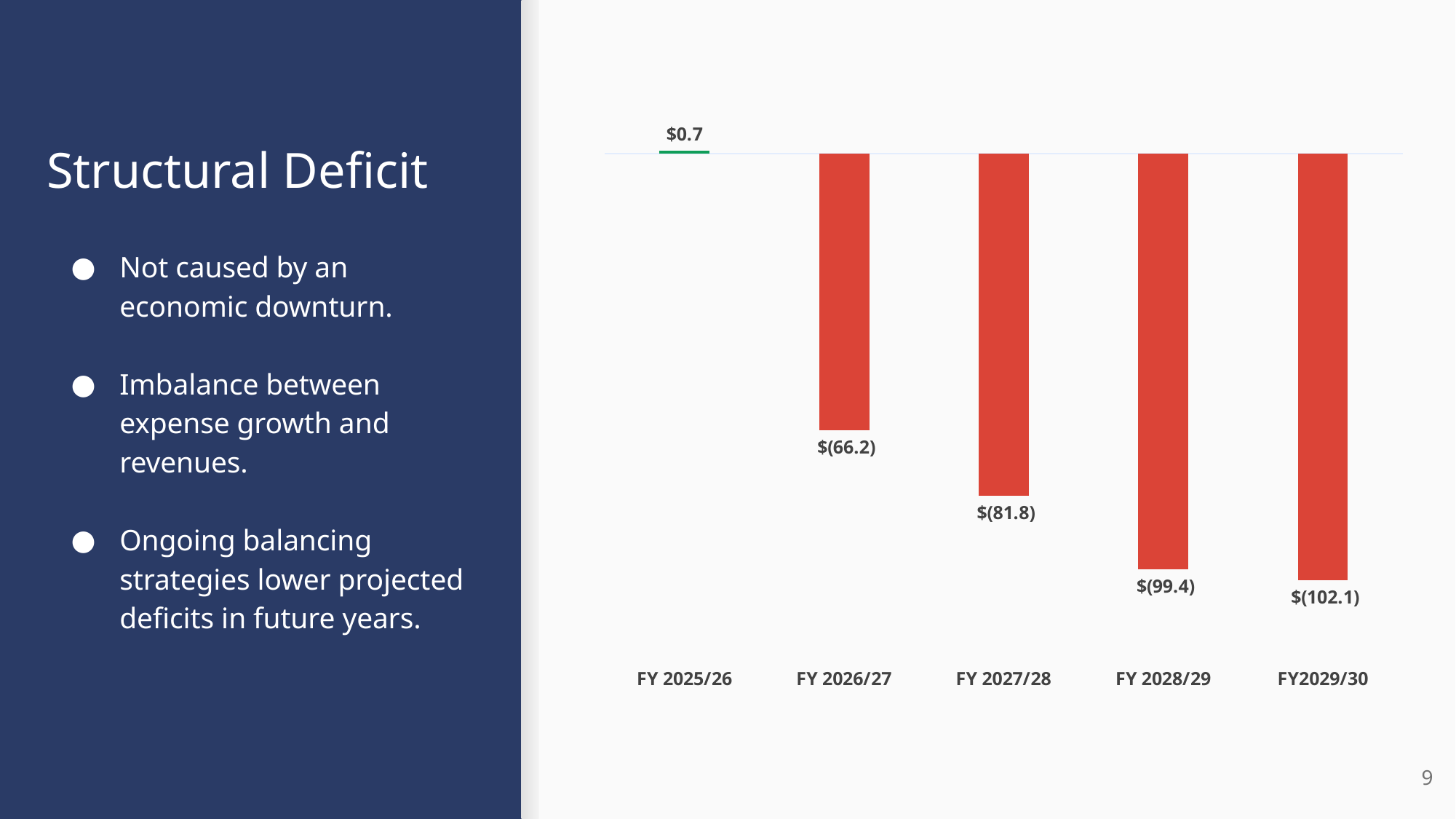
Which fiscal year has the lowest value (largest deficit)? FY2029/30 What kind of chart is shown on the slide? Bar chart What is the value for FY 2025/26? $0.7 By how much does the deficit for FY 2027/28 exceed the deficit for FY 2026/27? $15.6 Which fiscal year has the larger deficit, FY 2028/29 or FY2029/30? FY2029/30 What is the value for FY2029/30? $(102.1) What is the value for FY 2026/27? $(66.2) How many fiscal years are shown on the chart? 5 Do the values rise or fall from FY 2025/26 to FY2029/30? Fall Which fiscal year has the highest value? FY 2025/26 What is the value for FY 2027/28? $(81.8) What is the value for FY 2028/29? $(99.4)